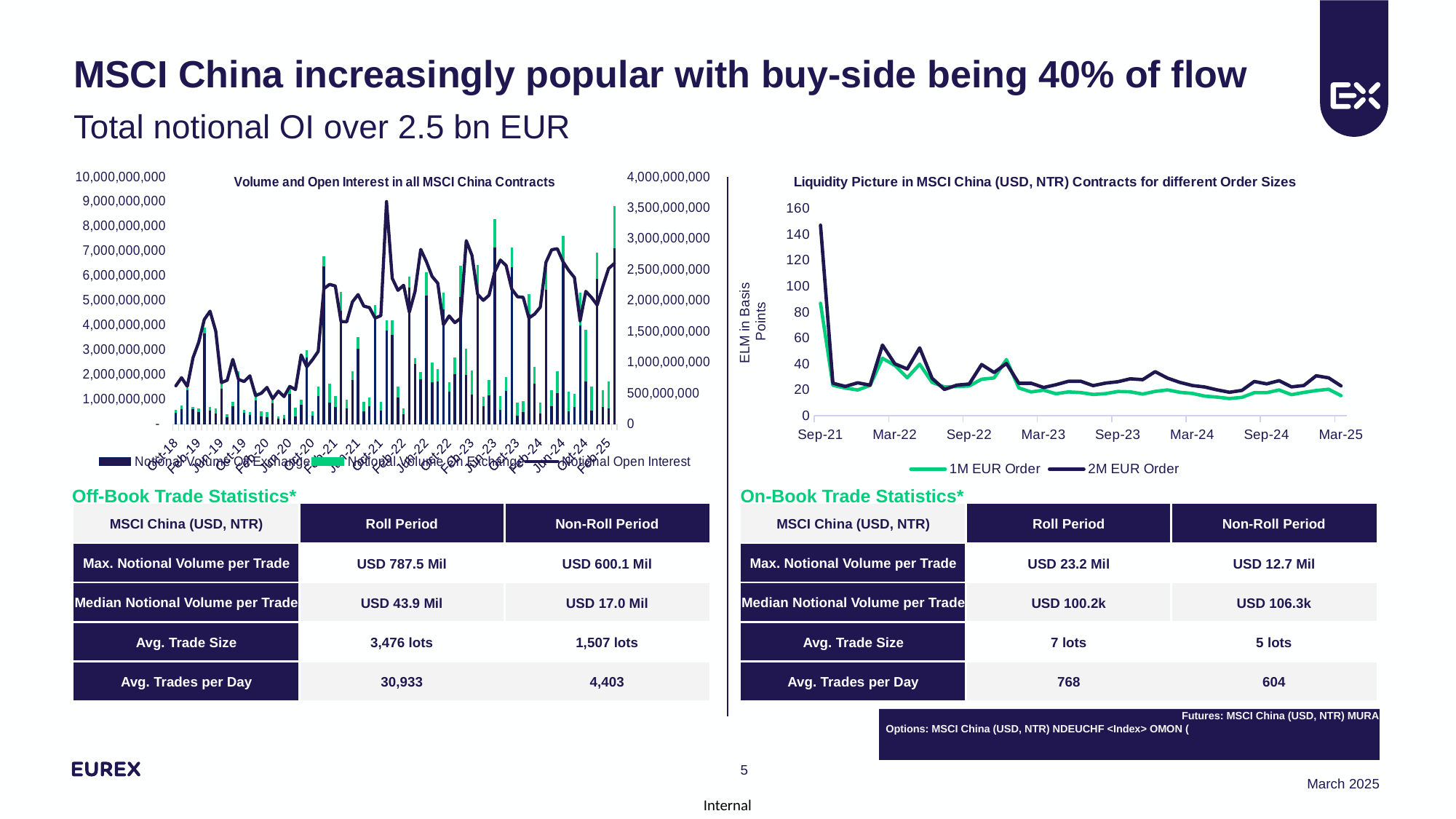
In the 'Liquidity Picture in MSCI China (USD, NTR) Contracts for different Order Sizes' chart, which series is higher at Mar-25, 1M EUR Order or 2M EUR Order? 2M EUR Order In the 'Liquidity Picture in MSCI China (USD, NTR) Contracts for different Order Sizes' chart, is the value of the 2M EUR Order series at Sep-21 greater or less than 120? greater In the 'Liquidity Picture in MSCI China (USD, NTR) Contracts for different Order Sizes' chart, at which date does the 2M EUR Order series reach its highest value? Sep-21 In the 'Liquidity Picture in MSCI China (USD, NTR) Contracts for different Order Sizes' chart, do the values of the 1M EUR Order series generally rise or fall from Sep-21 to Mar-25? Fall In the 'Liquidity Picture in MSCI China (USD, NTR) Contracts for different Order Sizes' chart, what are the two series named in the legend? 1M EUR Order and 2M EUR Order What is the highest tick value shown on the left vertical axis of the 'Volume and Open Interest in all MSCI China Contracts' chart? 10,000,000,000 In the 'Liquidity Picture in MSCI China (USD, NTR) Contracts for different Order Sizes' chart, what is the label of the vertical axis? ELM in Basis Points What type of chart is the 'Liquidity Picture in MSCI China (USD, NTR) Contracts for different Order Sizes' chart? Line chart In the 'Liquidity Picture in MSCI China (USD, NTR) Contracts for different Order Sizes' chart, is the value of the 2M EUR Order series at Mar-25 greater or less than 40? less How many series does the legend of the 'Liquidity Picture in MSCI China (USD, NTR) Contracts for different Order Sizes' chart list? 2 In the 'Liquidity Picture in MSCI China (USD, NTR) Contracts for different Order Sizes' chart, is the value of the 1M EUR Order series at Mar-25 greater or less than 20? less How many series does the legend of the 'Volume and Open Interest in all MSCI China Contracts' chart list? 3